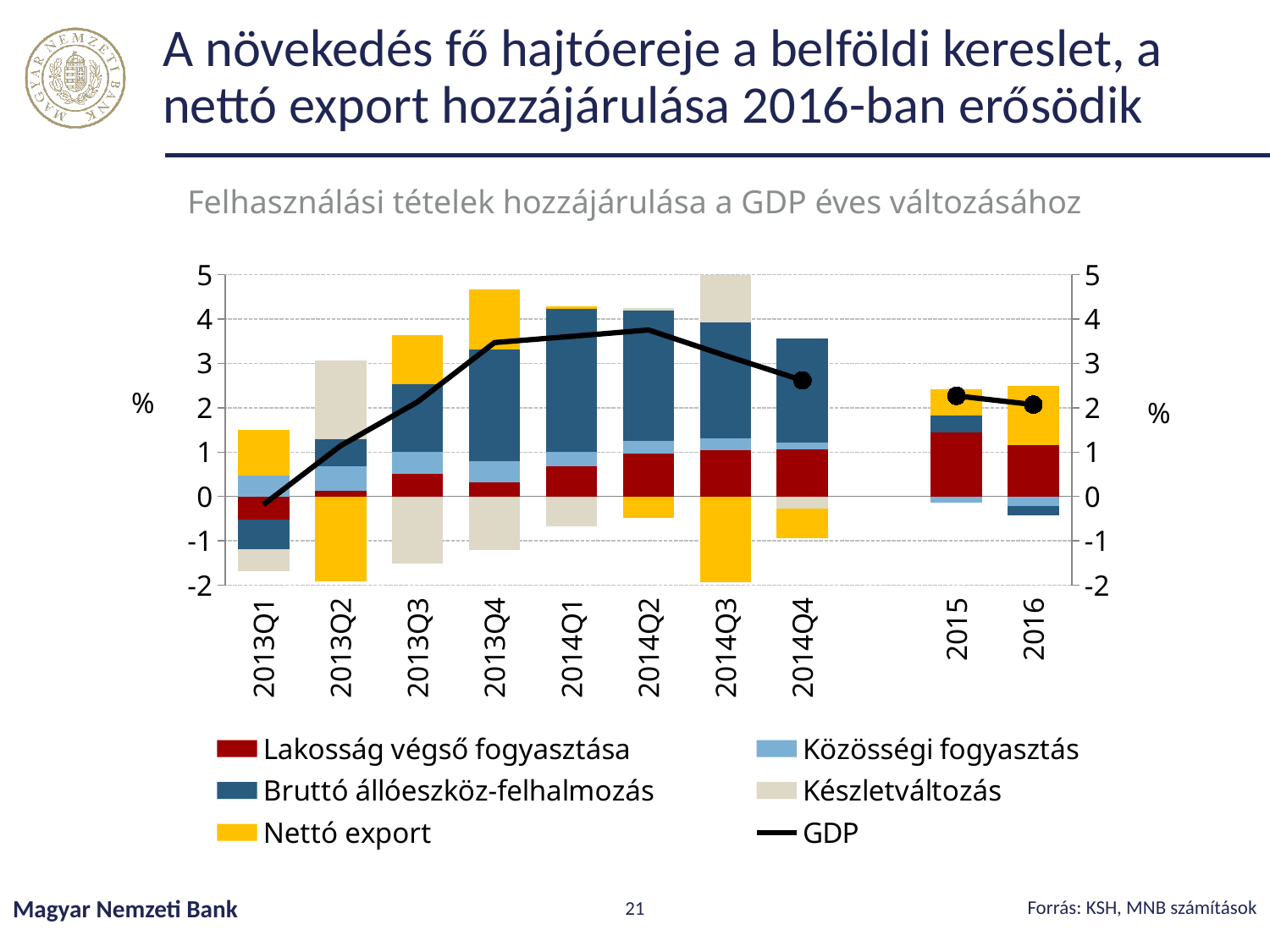
How many series does the legend list? 6 Does the GDP line rise or fall from 2014Q2 to 2016? fall What is the subtitle of the chart? Felhasználási tételek hozzájárulása a GDP éves változásához Is the Lakosság végső fogyasztása value for 2015 greater or less than 1? greater Which is larger, the GDP value for 2013Q1 or for 2014Q2? 2014Q2 How many categories are shown on the x axis? 10 Is the GDP value for 2016 greater or less than 3? less Which series is drawn as a line rather than bars? GDP Is the GDP value for 2013Q4 greater or less than 3? greater What kind of chart is shown on the slide? Stacked bar chart with a line In which category is the GDP line at its lowest? 2013Q1